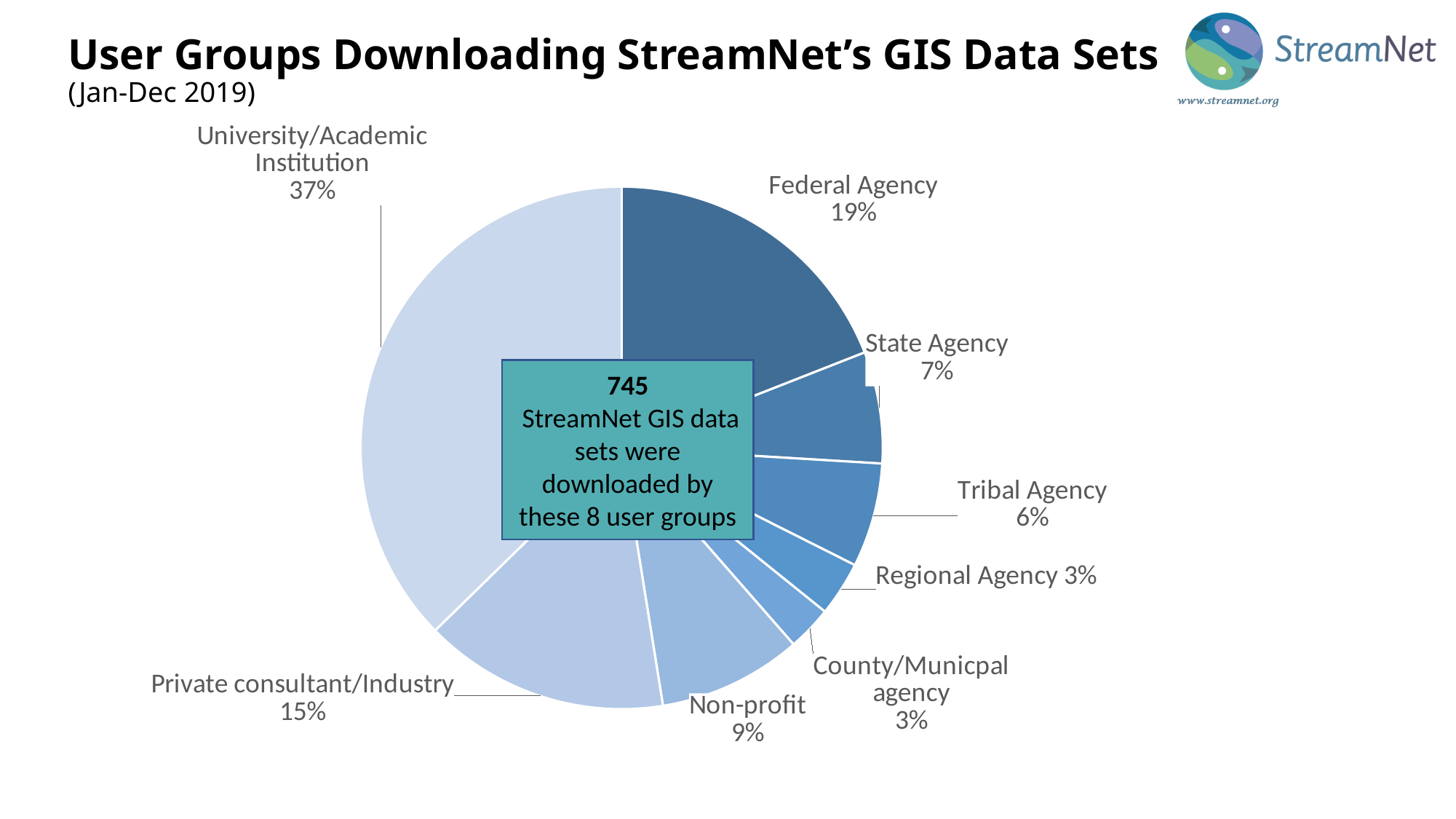
What time period does the chart cover, according to the subtitle? Jan-Dec 2019 What percentage is shown for Regional Agency? 3% What is the difference in percentage points between Federal Agency and State Agency? 12 What percentage is shown for Private consultant/Industry? 15% How many user groups are shown in the pie chart? 8 What kind of chart is shown on the slide? pie chart Which user group has the largest share of downloads? University/Academic Institution What percentage is shown for Non-profit? 9% How many StreamNet GIS data sets were downloaded in total according to the centre box? 745 What share of downloads came from University/Academic Institution users? 37% Which is larger, the share for Tribal Agency or the share for Non-profit? Non-profit What share of downloads came from Federal Agency users? 19%